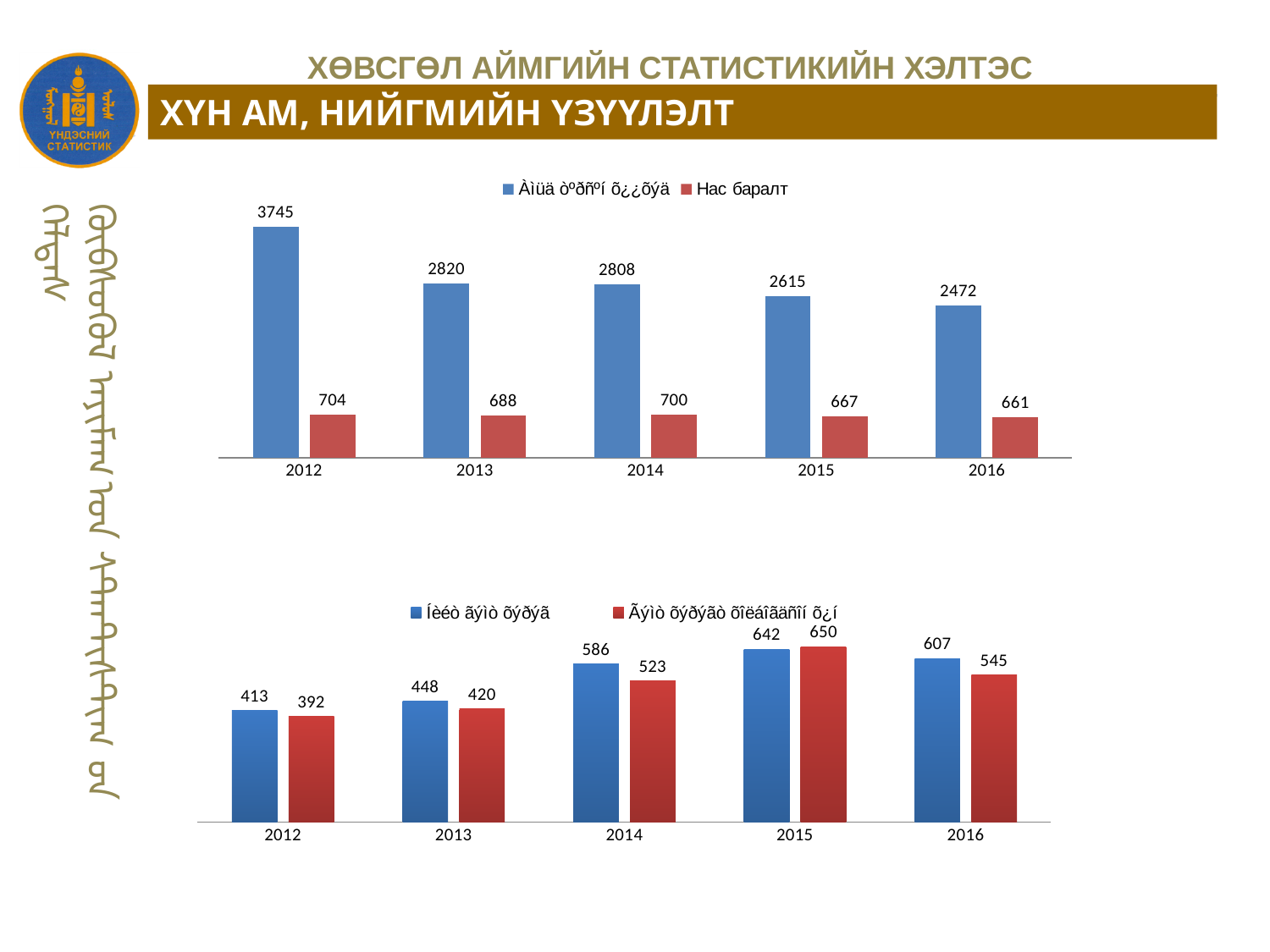
In the top chart, which year has the lowest 'Нас баралт' (red) value? 2016 In the bottom chart, what is the value of the red bar for 2016? 545 In the bottom chart, which year has the highest red bar? 2015 In the top chart, do the blue bar values rise or fall from 2012 to 2016? fall In the bottom chart, what is the value of the blue bar for 2014? 586 In the top chart, what is the difference between the blue bar values for 2012 and 2016? 1273 In the top chart, what is the value of the 'Нас баралт' (red) bar for 2015? 667 In the top chart, what is the value of the blue bar for 2012? 3745 What type of chart is the bottom chart? bar chart In the top chart, which year has the highest blue bar? 2012 In the bottom chart, which is larger for 2015, the blue bar or the red bar? the red bar In the top chart, how many years are shown on the x axis? 5